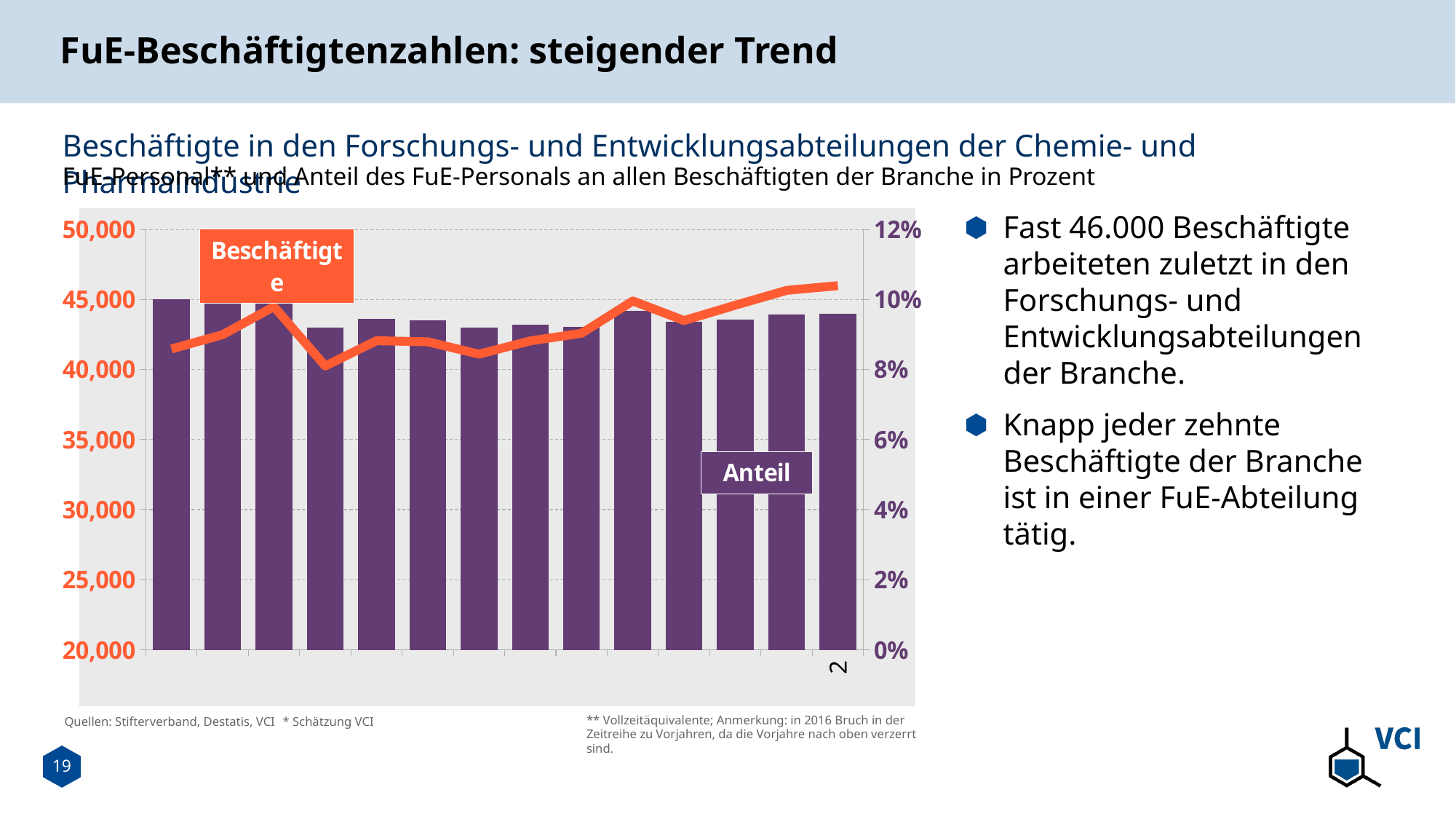
How many bars are plotted in the chart? 14 Is the Anteil value at the last (rightmost) point greater or less than 8%? greater Which is larger: the Anteil value at the first point or at the last point? The first point Which series is drawn as a line in the chart? Beschäftigte What kind of chart is shown on the slide? A bar chart combined with a line chart Which is larger: the first (leftmost) bar or the fifth bar from the left? The first bar Which series is drawn as bars in the chart? Anteil How many series does the chart show? 2